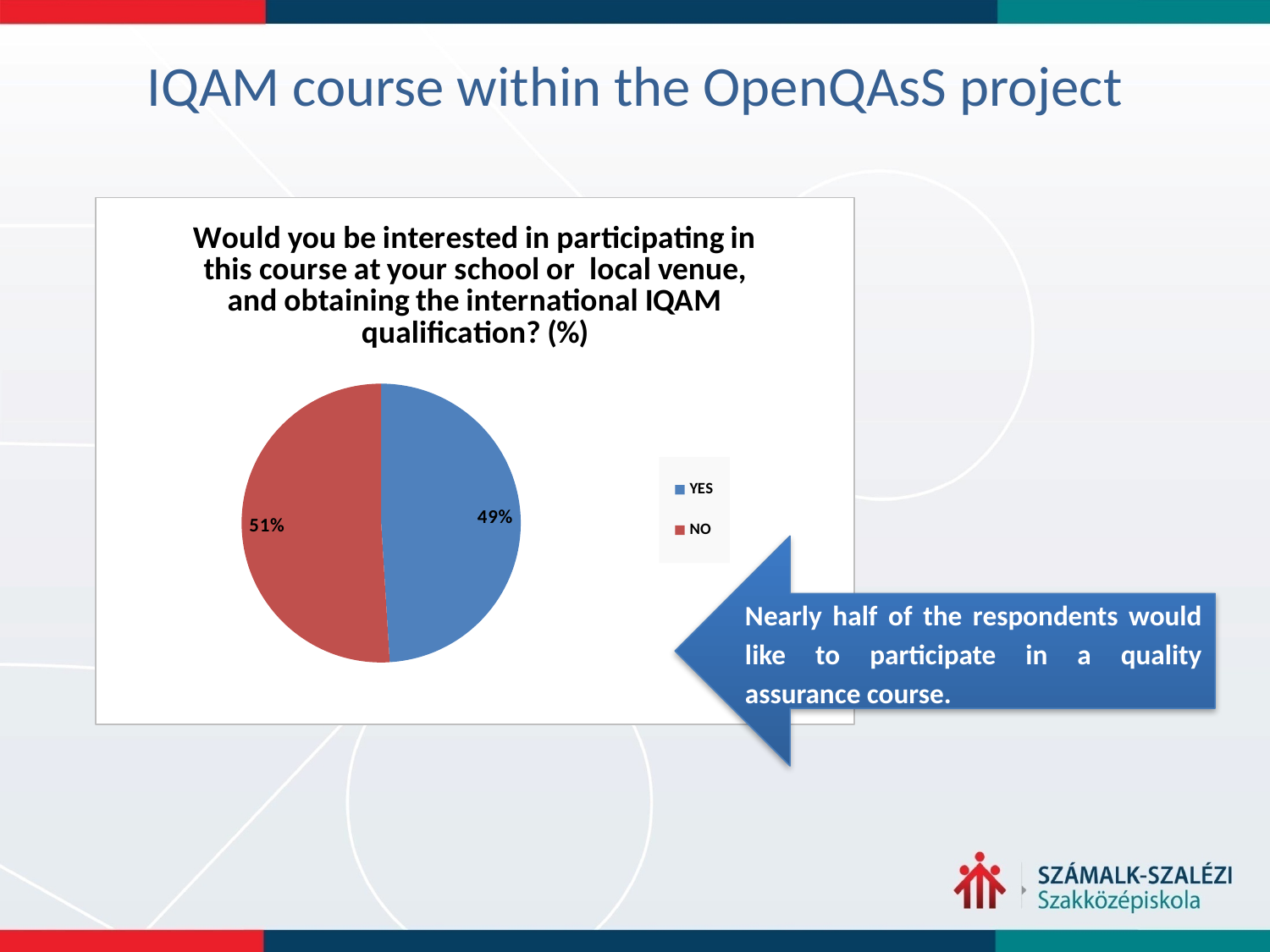
What percentage of respondents answered NO? 51% What percentage of respondents answered YES? 49% How many entries does the legend list? 2 Which response has the larger share, YES or NO? NO What colour is the NO slice? red What colour is the YES slice? blue How many slices does the pie chart have? 2 What is the difference in percentage points between the NO and YES slices? 2 What kind of chart is shown on the slide? pie chart Which category has the smallest slice of the pie? YES What is the total of the two slices shown in the pie chart? 100% Which category has the largest slice of the pie? NO